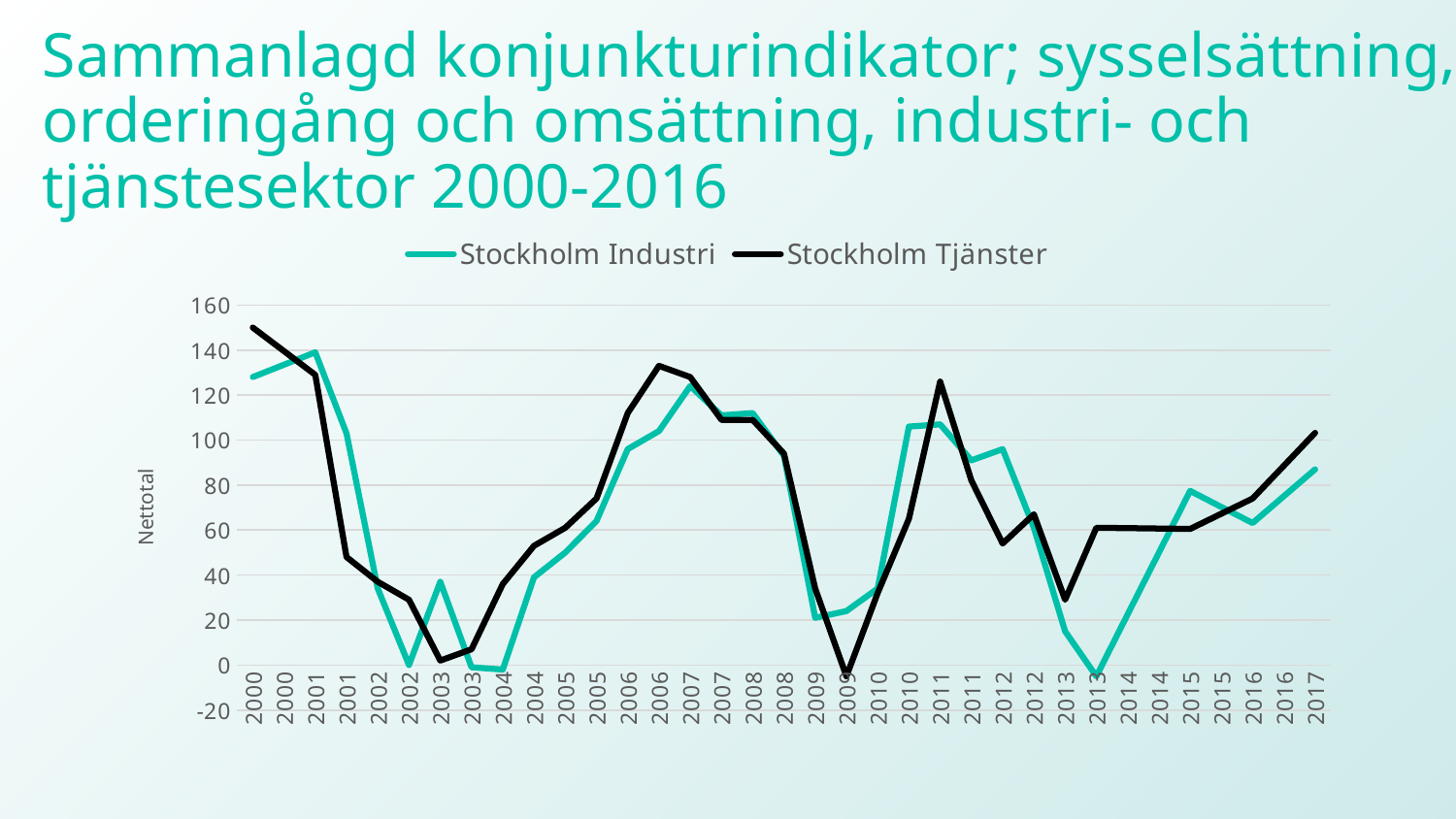
At which x-axis point does Stockholm Tjänster reach its highest value? 2000 (first point) Is the value for Stockholm Industri at the first 2000 point greater or less than 120? greater Is the value for Stockholm Industri at the second 2013 point greater or less than 20? less What kind of chart is shown on the slide? Line chart Is the value for Stockholm Tjänster at the first 2000 point greater or less than 140? greater What are the two series named in the legend? Stockholm Industri and Stockholm Tjänster How many series does the legend list? 2 At 2017, which series has the higher value, Stockholm Industri or Stockholm Tjänster? Stockholm Tjänster What is the label on the vertical axis? Nettotal Does the Stockholm Tjänster line rise or fall from 2015 to 2017? Rise At the first 2000 point, which series has the higher value, Stockholm Industri or Stockholm Tjänster? Stockholm Tjänster